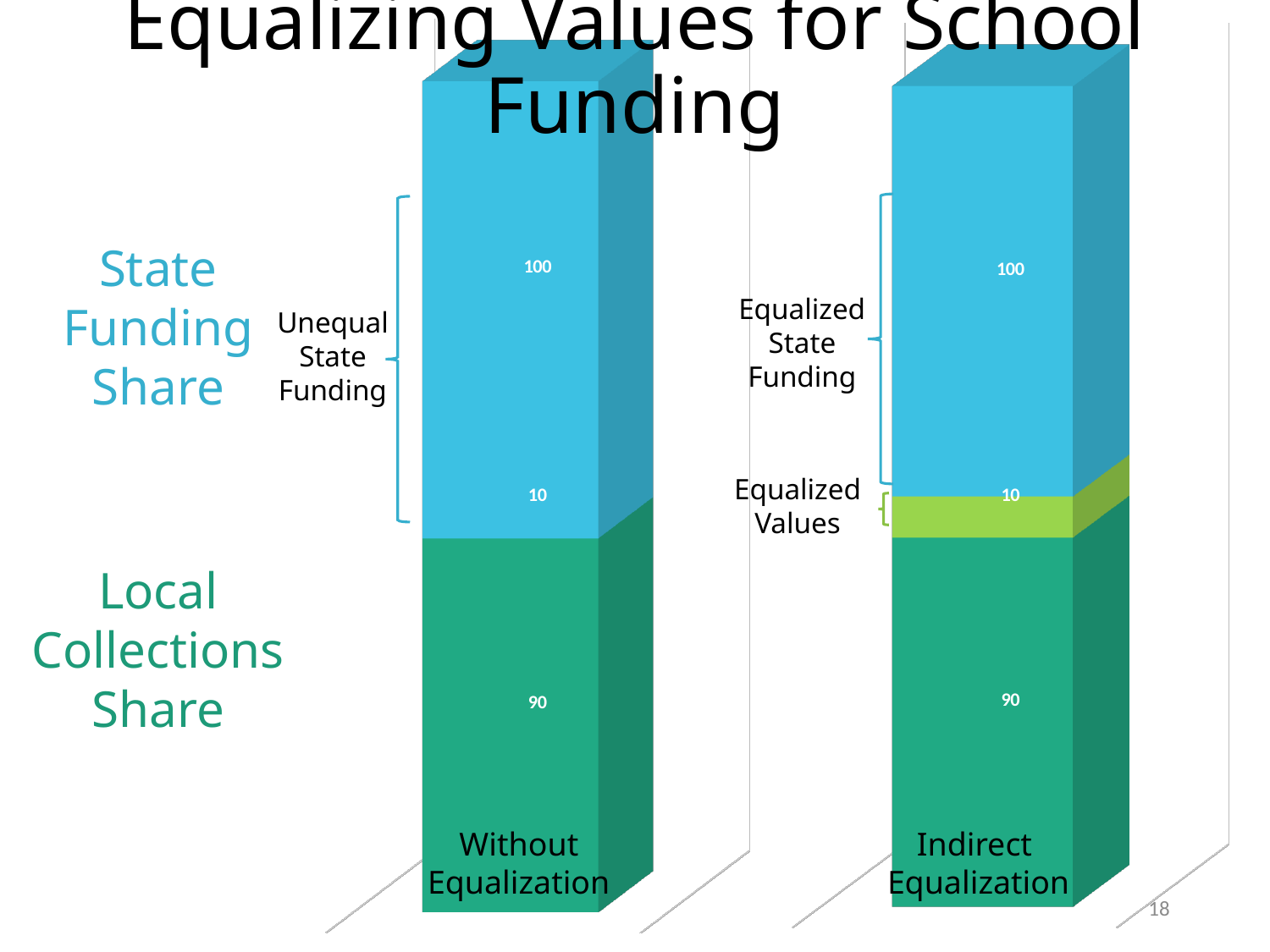
In the Indirect Equalization bar, what is the difference between the top segment (100) and the bottom segment (90)? 10 What are the two categories labelled along the bottom of the chart? Without Equalization and Indirect Equalization What kind of chart is shown on the slide? Stacked bar chart What is the total of all segments in the Without Equalization bar? 200 What is the value of the bottom (Local Collections Share) segment of the Without Equalization bar? 90 What is the title of the chart slide? Equalizing Values for School Funding What is the value of the top segment of the Indirect Equalization bar? 100 In the Without Equalization bar, which is larger: the top segment or the bottom segment? The top segment (100) What is the value of the bottom segment of the Indirect Equalization bar? 90 What is the total of all segments in the Indirect Equalization bar? 200 How many bars (categories) does the chart show? 2 What is the value of the segment labelled Equalized Values in the Indirect Equalization bar? 10